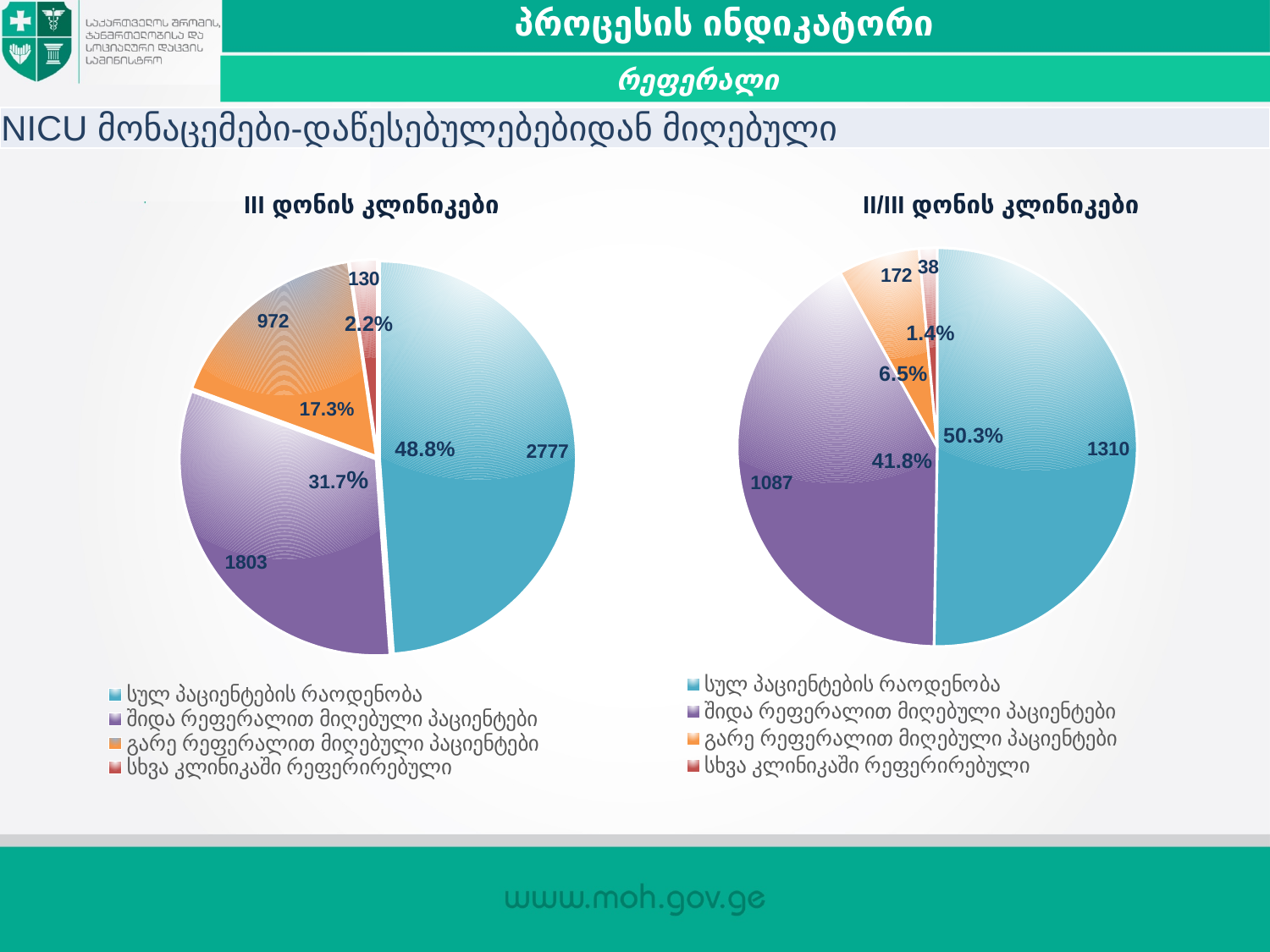
In the "III დონის კლინიკები" chart, what value is shown for სულ პაციენტების რაოდენობა? 2777 In the "II/III დონის კლინიკები" chart, which is larger: გარე რეფერალით მიღებული პაციენტები or სხვა კლინიკაში რეფერირებული? გარე რეფერალით მიღებული პაციენტები In the "III დონის კლინიკები" chart, what value is shown for გარე რეფერალით მიღებული პაციენტები? 972 What type of chart is "III დონის კლინიკები"? Pie chart How many categories does the legend of the "II/III დონის კლინიკები" chart list? 4 In the "III დონის კლინიკები" chart, what percentage share is shown for შიდა რეფერალით მიღებული პაციენტები? 31.7% In the "II/III დონის კლინიკები" chart, what percentage share is shown for სულ პაციენტების რაოდენობა? 50.3% In the "II/III დონის კლინიკები" chart, what value is shown for შიდა რეფერალით მიღებული პაციენტები? 1087 In the "III დონის კლინიკები" chart, which category has the smallest slice? სხვა კლინიკაში რეფერირებული In the "II/III დონის კლინიკები" chart, what value is shown for სხვა კლინიკაში რეფერირებული? 38 In the "II/III დონის კლინიკები" chart, which category has the largest slice? სულ პაციენტების რაოდენობა In the "III დონის კლინიკები" chart, what is the difference between the values for სულ პაციენტების რაოდენობა and შიდა რეფერალით მიღებული პაციენტები? 974